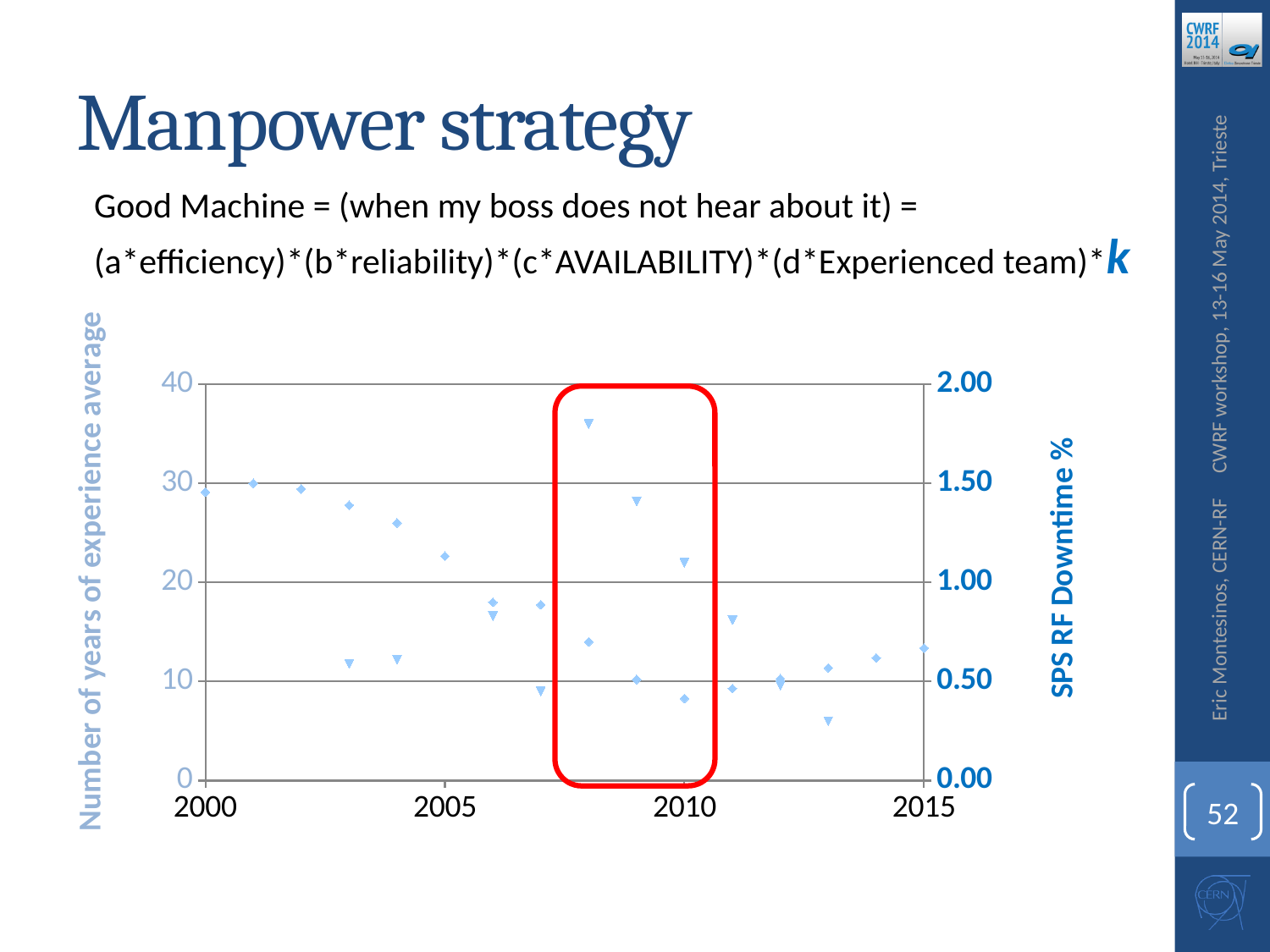
What kind of chart is shown on the slide? scatter chart What is the title of the right vertical axis? SPS RF Downtime % Is the SPS RF Downtime % for 2008 greater or less than 1.50? greater Is the number of years of experience average for 2005 greater or less than 20? greater Does the number of years of experience average rise or fall from 2000 to 2010? fall Is the SPS RF Downtime % for 2013 greater or less than 0.50? less Which year has the larger number of years of experience average, 2000 or 2015? 2000 What is the title of the left vertical axis? Number of years of experience average In which year is the SPS RF Downtime % highest? 2008 In which year is the SPS RF Downtime % lowest? 2013